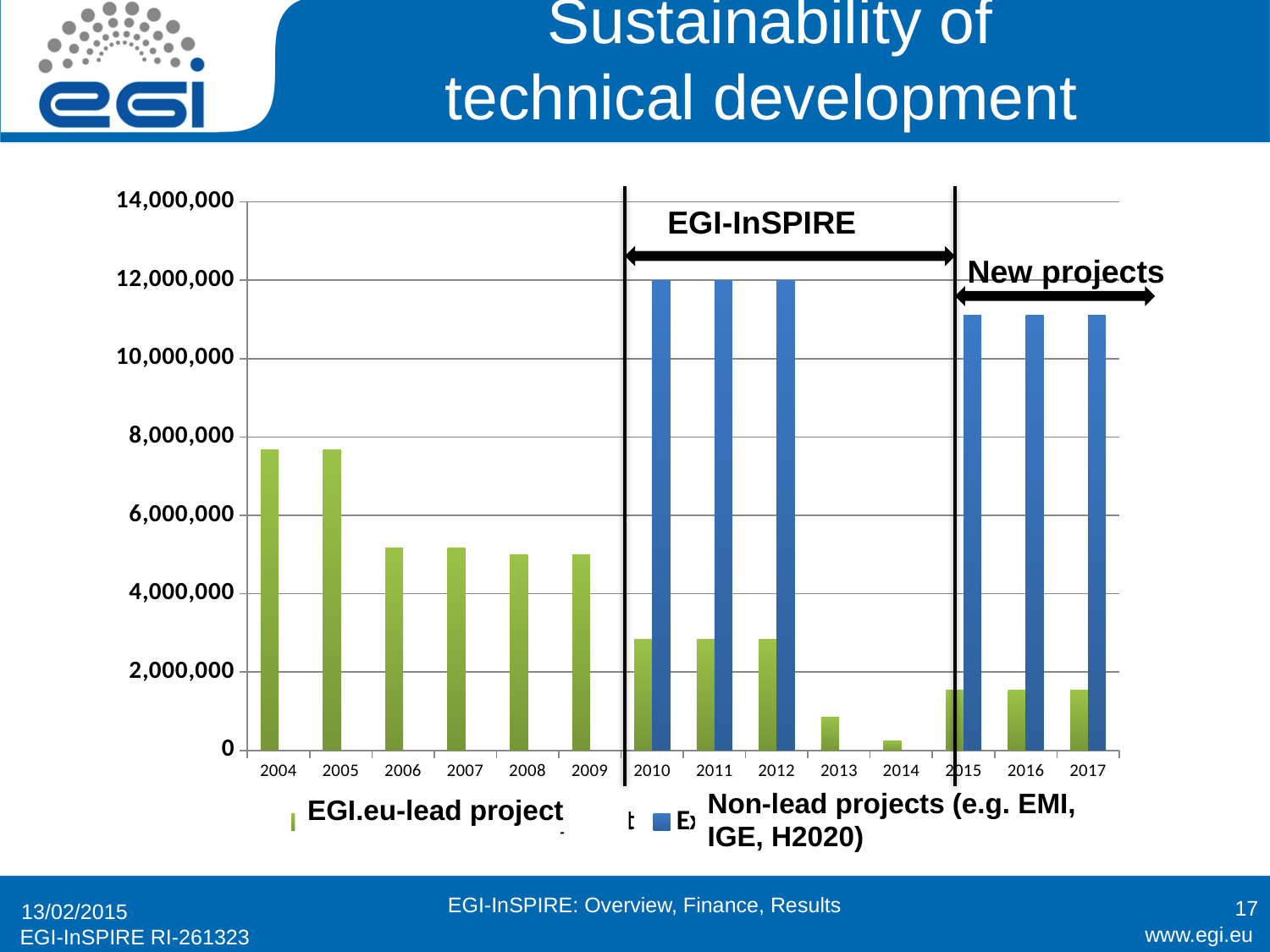
How many series does the chart's legend list? 2 Do the EGI.eu-lead project values rise or fall from 2004 to 2009? fall Which is larger: the Non-lead projects value in 2012 or in 2016? 2012 Is the value for EGI.eu-lead project in 2006 greater or less than 4,000,000? greater In 2010, which series has the larger value: EGI.eu-lead project or Non-lead projects? Non-lead projects How many years are shown on the x axis of the chart? 14 What kind of chart is shown on the slide? bar chart In which year is the EGI.eu-lead project value lowest? 2014 Is the value for EGI.eu-lead project in 2004 greater or less than 6,000,000? greater Is the value for EGI.eu-lead project in 2014 greater or less than 2,000,000? less Which project period is labelled above the bars for 2010 to 2014? EGI-InSPIRE